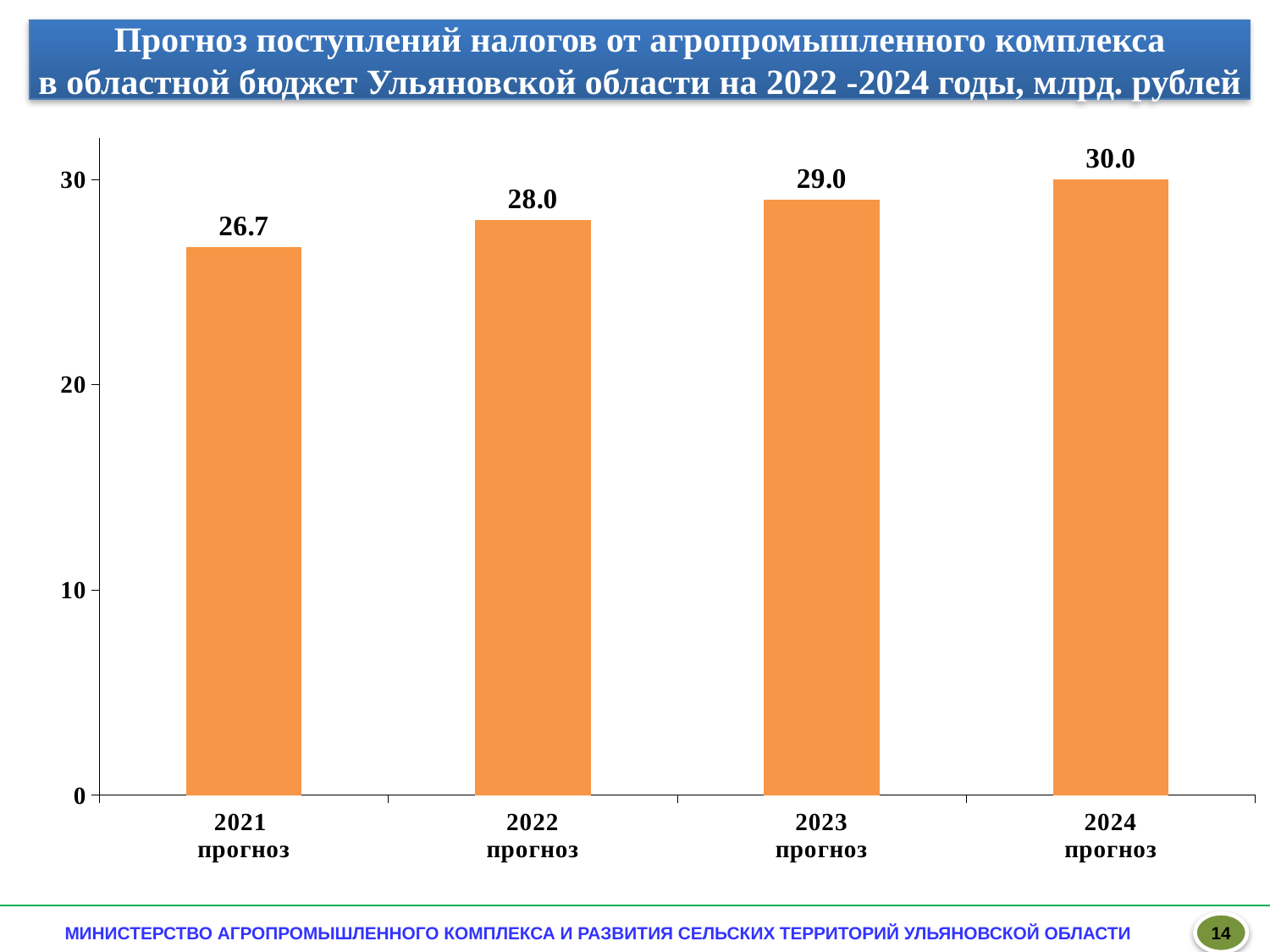
What is the forecast value for 2023 прогноз? 29.0 Do the values rise or fall from 2021 to 2024? rise What is the difference between the values for 2023 прогноз and 2022 прогноз? 1.0 What kind of chart is shown on the slide? bar chart What is the forecast value for 2021 прогноз? 26.7 How many bars are shown in the chart? 4 Which year has the highest forecast value? 2024 прогноз What is the forecast value for 2024 прогноз? 30.0 Which is larger, the value for 2022 прогноз or 2023 прогноз? 2023 прогноз What is the difference between the values for 2024 прогноз and 2021 прогноз? 3.3 Is the value for 2021 прогноз greater or less than 20? greater Which year has the lowest forecast value? 2021 прогноз